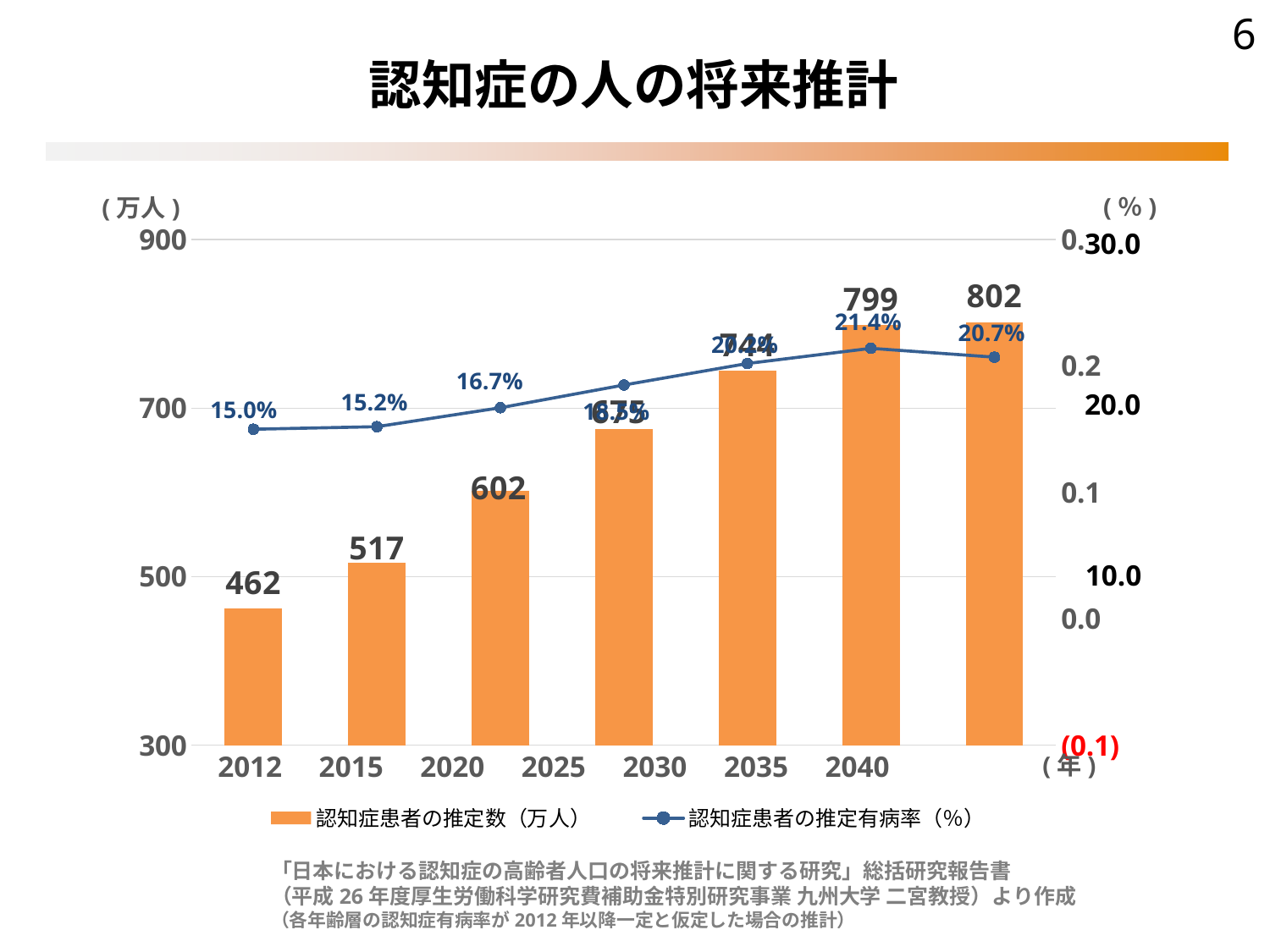
What is the value of 認知症患者の推定数（万人） for 2020? 602 Which year has the lowest value for 認知症患者の推定数（万人）? 2012 What is the highest value shown for 認知症患者の推定数（万人）? 802 What is the highest 認知症患者の推定有病率（%） value labelled on the line? 21.4% Do the bars for 認知症患者の推定数（万人） generally rise or fall from left to right? Rise What is the difference in 認知症患者の推定数（万人） between 2020 and 2012? 140 What is the value of 認知症患者の推定数（万人） for 2012? 462 What is the value of 認知症患者の推定数（万人） for 2015? 517 What kind of chart is shown on the slide? A combination bar and line chart What is the 認知症患者の推定有病率（%） for 2012? 15.0% What is the 認知症患者の推定有病率（%） for 2020? 16.7% How many series does the legend list? 2